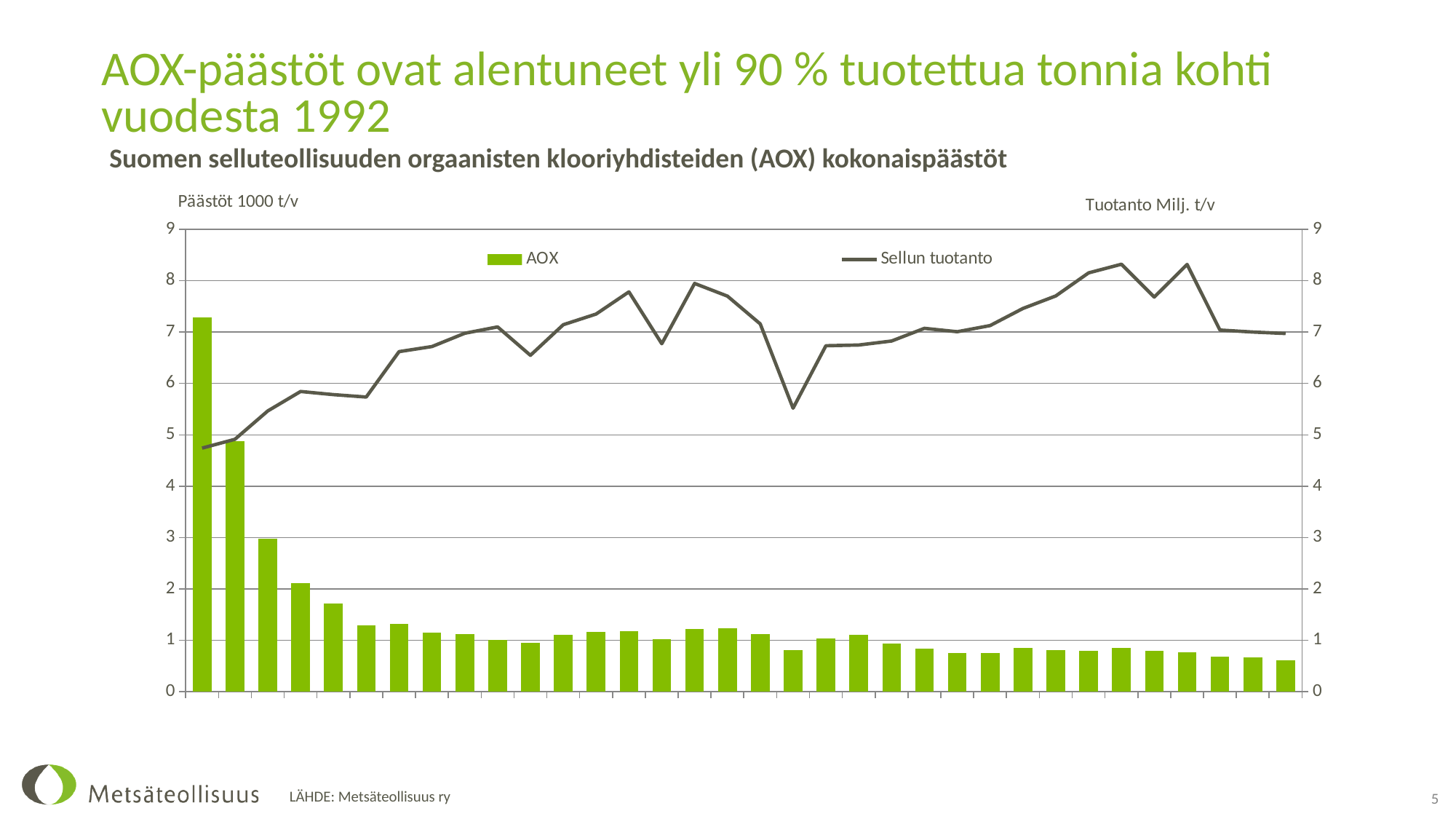
What kind of chart is shown on the slide? A bar chart combined with a line How many series does the chart legend list? 2 What are the two series named in the chart legend? AOX and Sellun tuotanto Which AOX bar is the highest in the chart? The first (leftmost) bar Which is larger, the first AOX bar or the second AOX bar? The first AOX bar Is the value of the last (rightmost) AOX bar greater or less than 1? less What is the label of the left vertical axis of the chart? Päästöt 1000 t/v Is the highest point of the Sellun tuotanto line greater or less than 8? greater Is the lowest point of the Sellun tuotanto line greater or less than 6? less Do the AOX bars generally rise or fall from left to right along the x axis? Fall How many AOX bars are plotted in the chart? 34